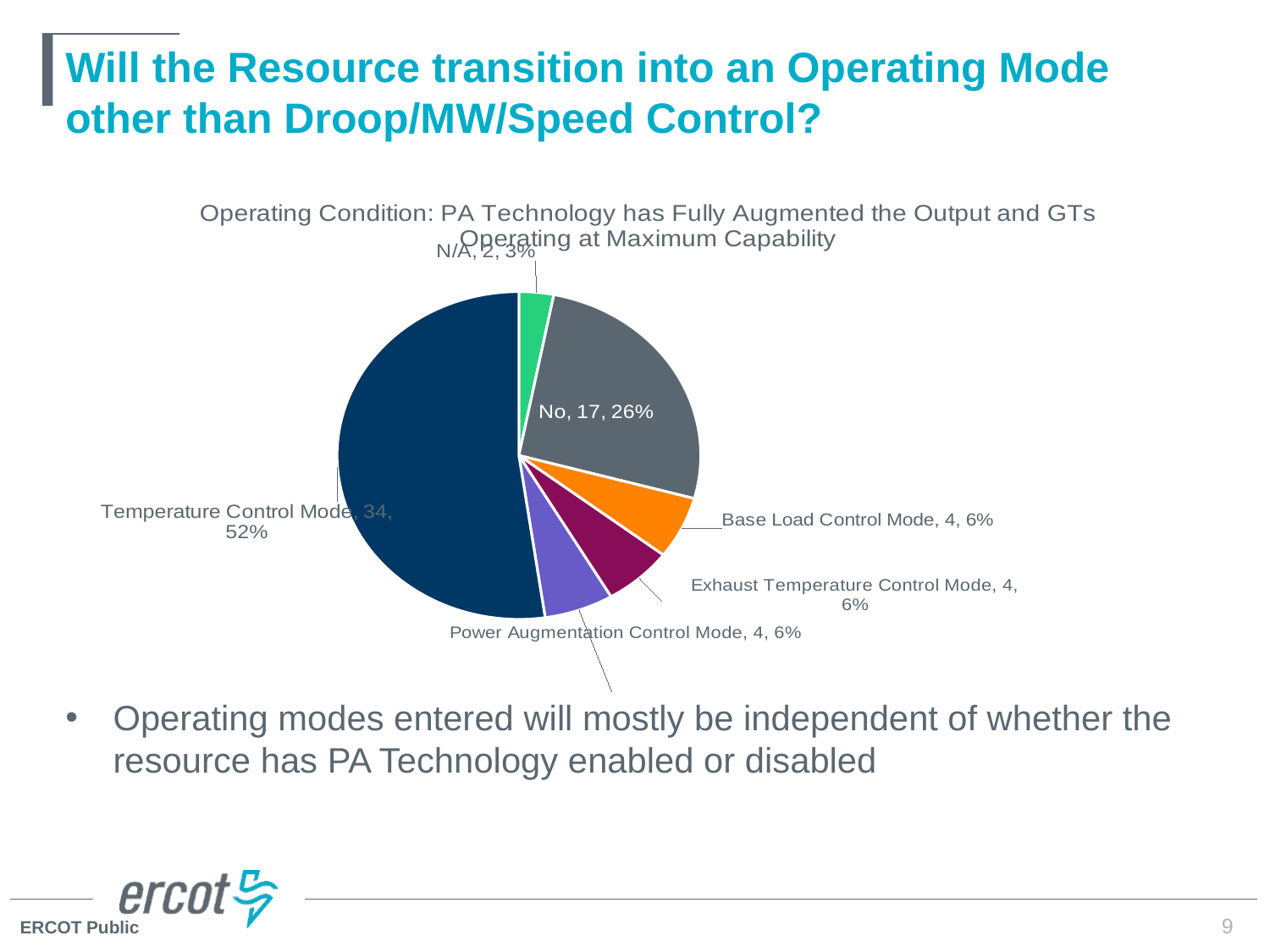
Which slice of the pie chart is the smallest? N/A What kind of chart is shown on the slide? Pie chart What is the total count across all slices of the pie chart? 65 What percentage share does the "N/A" slice have? 3% What is the title of the pie chart? Operating Condition: PA Technology has Fully Augmented the Output and GTs Operating at Maximum Capability Which slice of the pie chart is the largest? Temperature Control Mode How many slices does the pie chart have? 6 What is the count for "Base Load Control Mode" in the pie chart? 4 What is the difference in count between "Temperature Control Mode" and "No"? 17 Which has a larger count, "No" or "Power Augmentation Control Mode"? No What percentage share does the "Temperature Control Mode" slice have? 52% What is the count for the "No" slice in the pie chart? 17